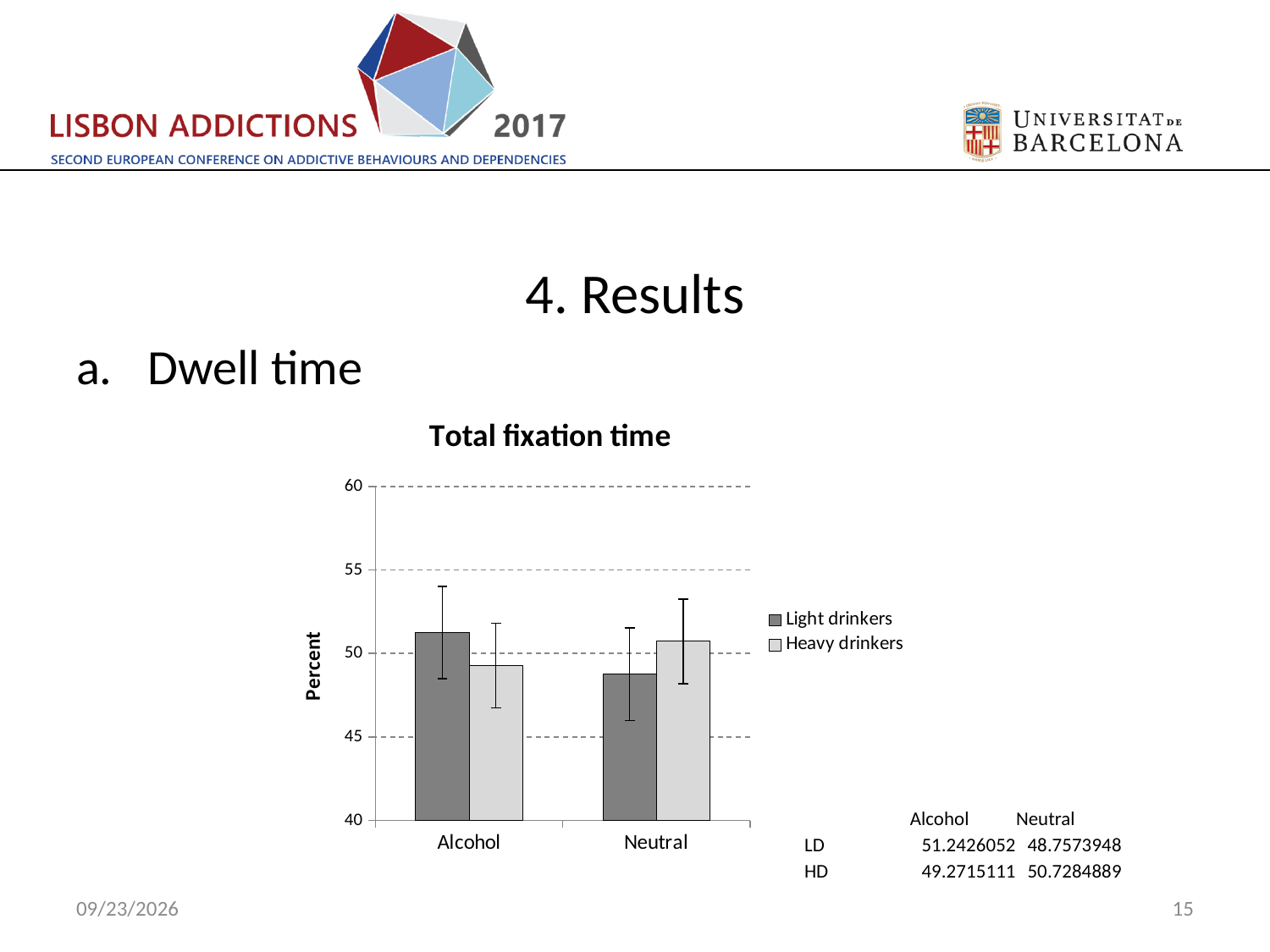
What is the label on the y axis of the 'Total fixation time' chart? Percent In the 'Total fixation time' chart, is the Light drinkers value for Neutral greater or less than 50? less In the 'Total fixation time' chart, for the Neutral category, which series has the larger value: Light drinkers or Heavy drinkers? Heavy drinkers In the 'Total fixation time' chart, do the Light drinkers values rise or fall from Alcohol to Neutral? fall According to the data table printed below the legend, what is the LD (Light drinkers) value for Alcohol? 51.2426052 In the 'Total fixation time' chart, is the Heavy drinkers value for Alcohol greater or less than 50? less In the 'Total fixation time' chart, for the Alcohol category, which series has the larger value: Light drinkers or Heavy drinkers? Light drinkers In the 'Total fixation time' chart, is the Light drinkers value for Alcohol greater or less than 50? greater What kind of chart is shown under the heading 'Total fixation time'? bar chart How many series does the legend of the 'Total fixation time' chart list? 2 How many categories are shown on the x axis of the 'Total fixation time' chart? 2 In the 'Total fixation time' chart, which category has the higher value for Light drinkers? Alcohol